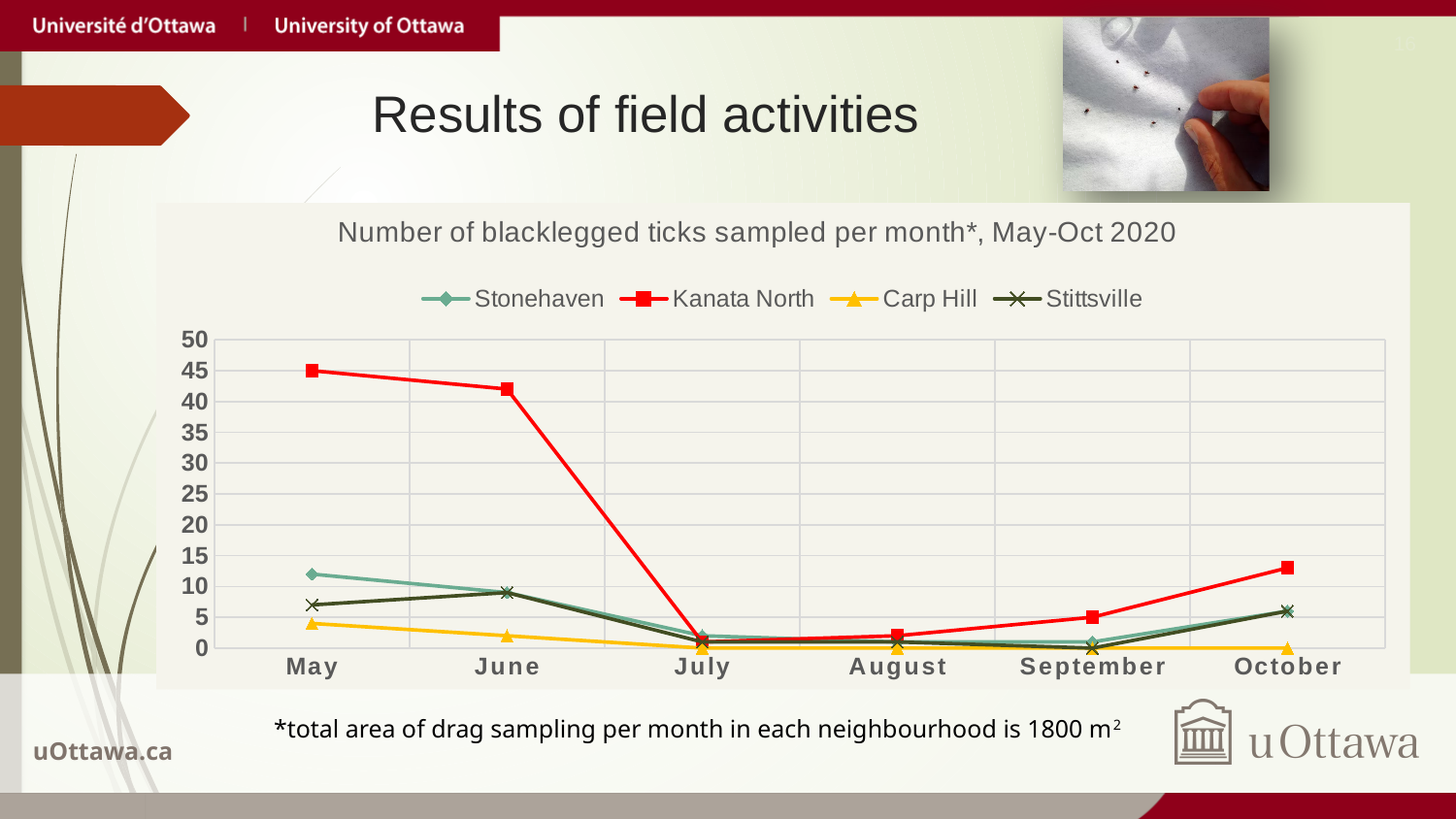
How many series does the legend list? 4 Which neighbourhood had the lowest number of ticks sampled in May? Carp Hill Do the values for Kanata North rise or fall from May to July? fall Which neighbourhood had the highest number of ticks sampled in May? Kanata North What kind of chart is shown on the slide? line chart Is the value for Stonehaven in May greater or less than 15? less How many months are shown on the x axis? 6 What is the title of the chart? Number of blacklegged ticks sampled per month*, May-Oct 2020 What is the value for Kanata North in May? 45 Is the value for Kanata North in June greater or less than 40? greater Which is larger in May, the value for Stonehaven or the value for Stittsville? Stonehaven What is the value for Carp Hill in October? 0